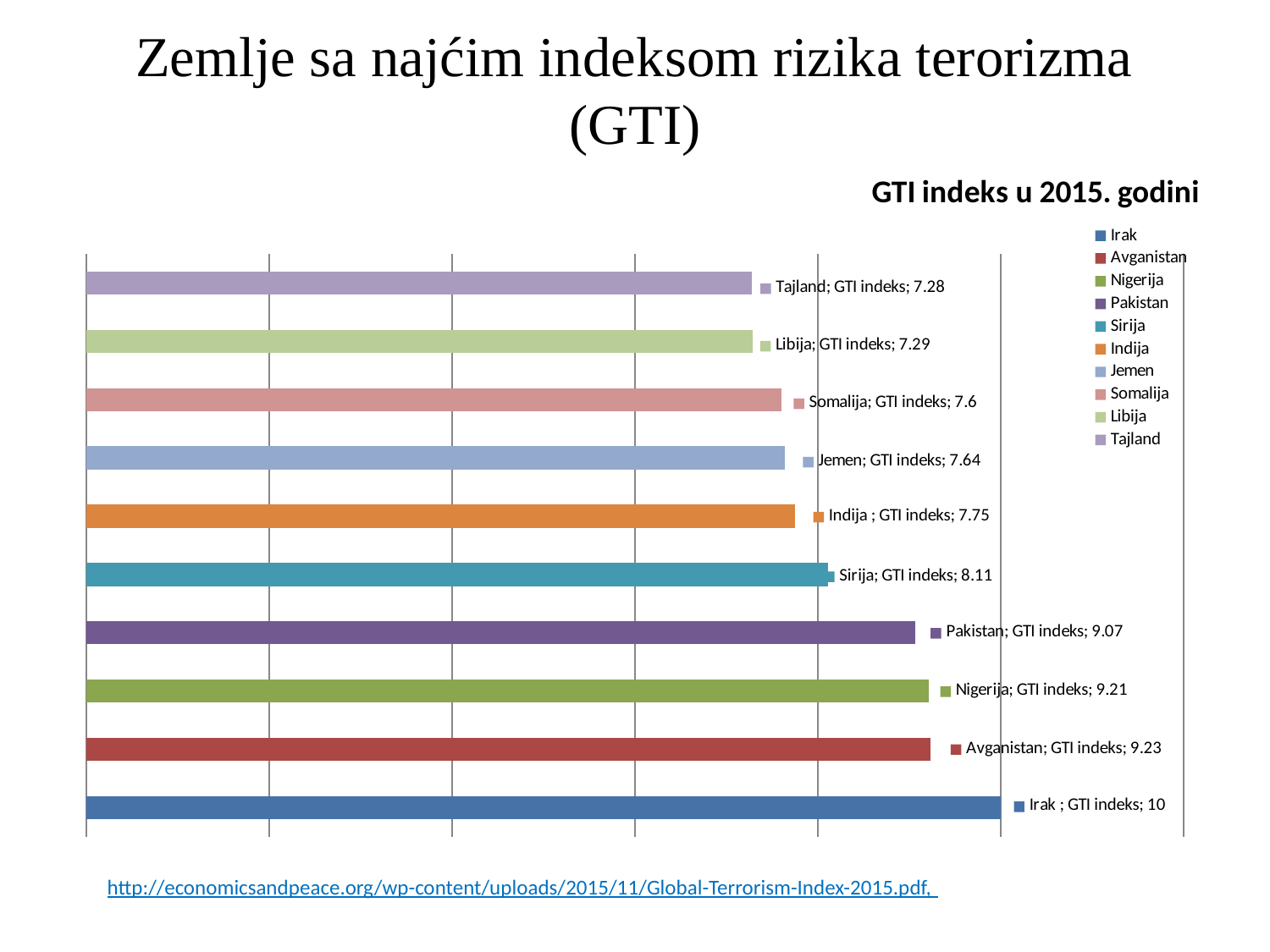
How many entries does the legend list? 10 Which country has the lowest GTI index? Tajland How many countries are shown in the chart? 10 What is the GTI index value for Irak? 10 What type of chart is shown on the slide? Bar chart What is the title of the chart? GTI indeks u 2015. godini What is the difference between the GTI index of Indija and Jemen? 0.11 What is the difference between the GTI index of Irak and Pakistan? 0.93 What is the GTI index value for Sirija? 8.11 Which country has the highest GTI index? Irak What is the GTI index value for Somalija? 7.6 Which has a higher GTI index, Sirija or Indija? Sirija